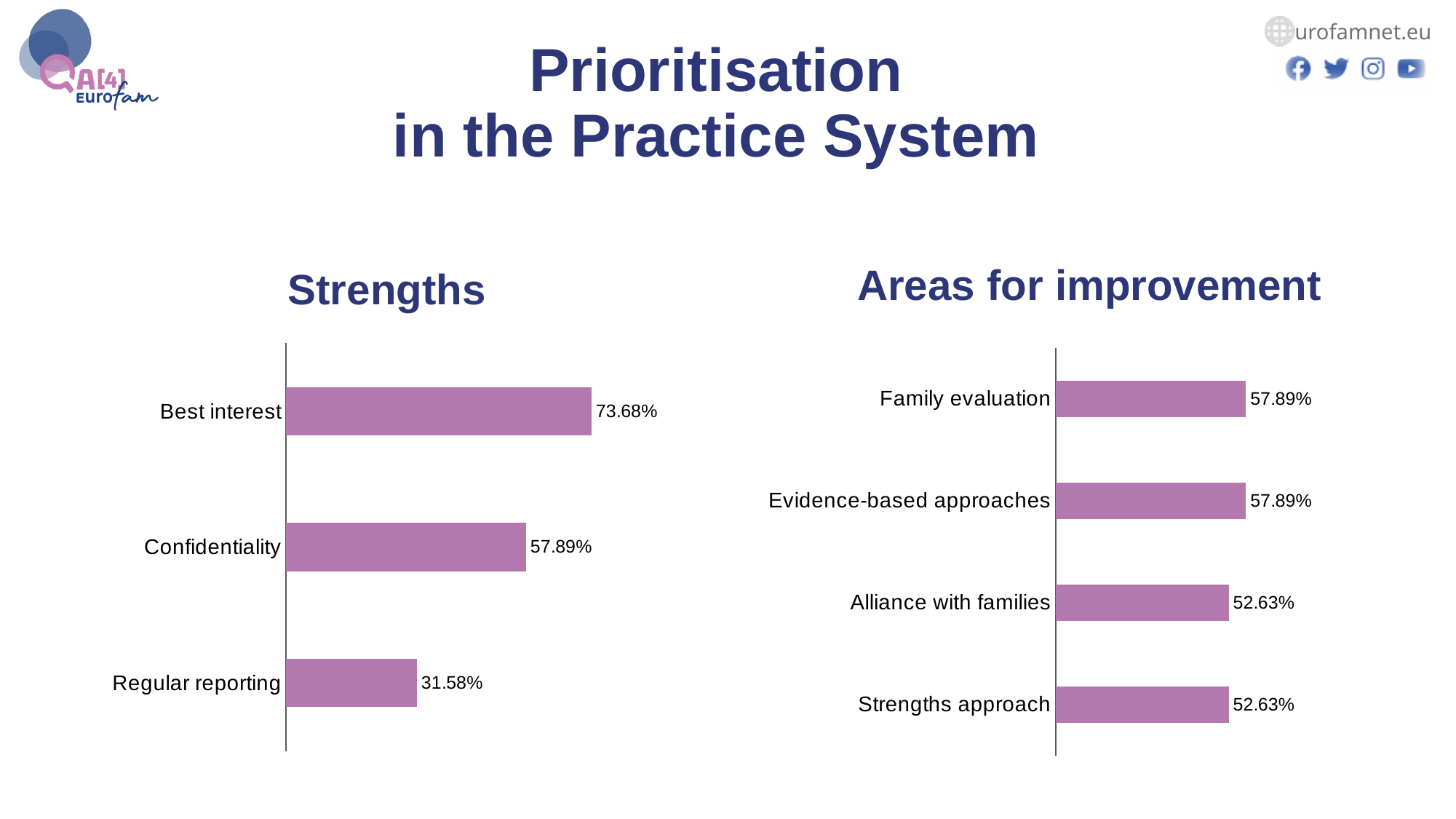
In the Strengths chart, which category has the lowest value? Regular reporting In the Strengths chart, which category has the highest value? Best interest In the Areas for improvement chart, what is the value for Family evaluation? 57.89% In the Areas for improvement chart, what is the difference between Evidence-based approaches and Strengths approach? 5.26% In the Strengths chart, what is the value for Regular reporting? 31.58% In the Areas for improvement chart, what is the value for Alliance with families? 52.63% What type of chart is the Strengths chart? Bar chart In the Strengths chart, which is larger: Confidentiality or Regular reporting? Confidentiality How many categories are shown in the Areas for improvement chart? 4 In the Strengths chart, what is the difference between Best interest and Confidentiality? 15.79% How many categories are shown in the Strengths chart? 3 In the Strengths chart, what is the value for Best interest? 73.68%